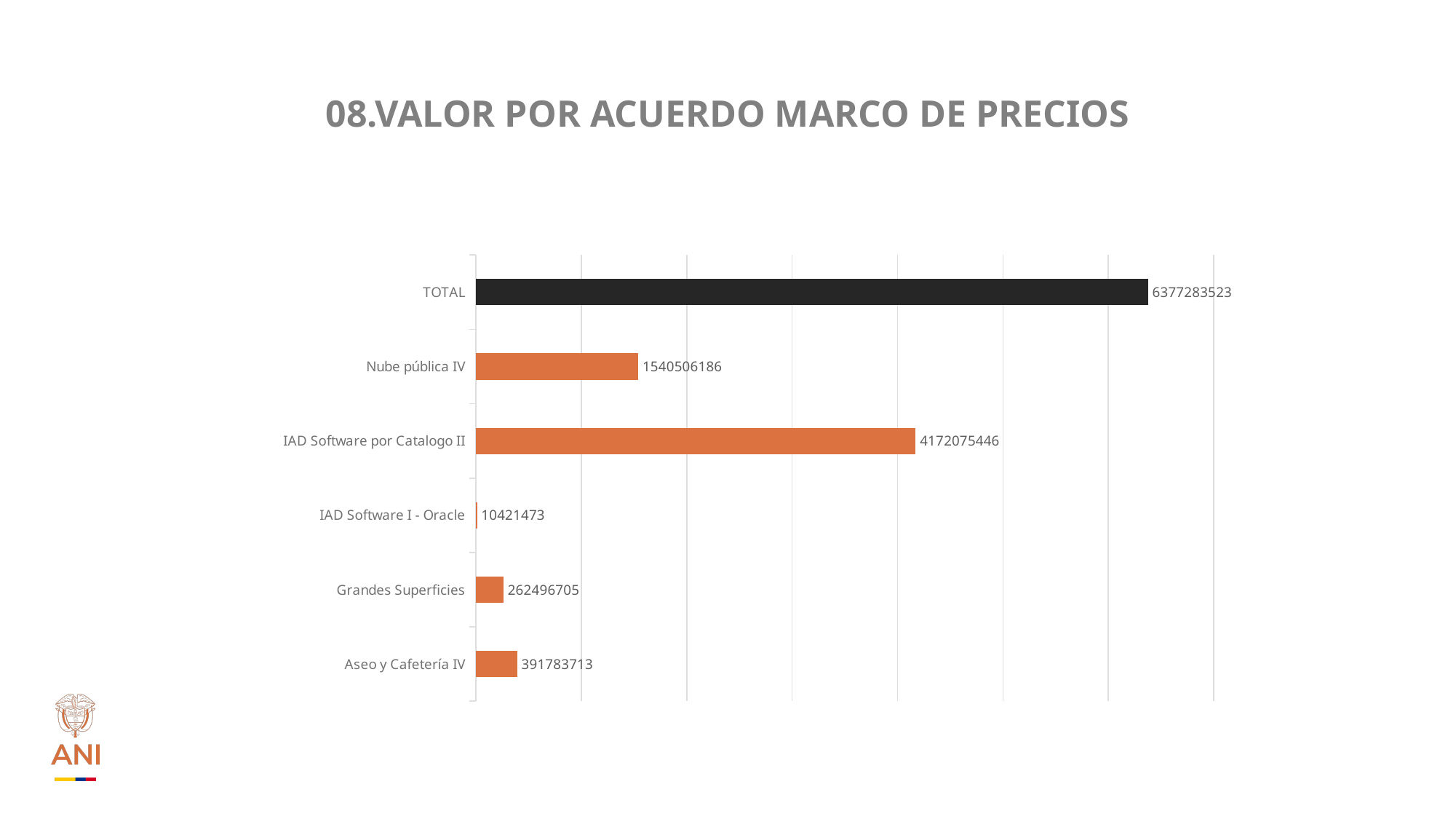
What kind of chart is shown on the slide? Bar chart Which is larger, the value for Nube pública IV or the value for Aseo y Cafetería IV? Nube pública IV What is the value for Aseo y Cafetería IV? 391783713 What is the value for Grandes Superficies? 262496705 What is the difference between the values for Aseo y Cafetería IV and Grandes Superficies? 129287008 Excluding the TOTAL bar, which category has the highest value? IAD Software por Catalogo II How many bars are shown in the chart, including TOTAL? 6 Which category has the lowest value? IAD Software I - Oracle What is the value for Nube pública IV? 1540506186 What is the value for IAD Software por Catalogo II? 4172075446 What is the value for IAD Software I - Oracle? 10421473 What is the value shown for the TOTAL bar? 6377283523